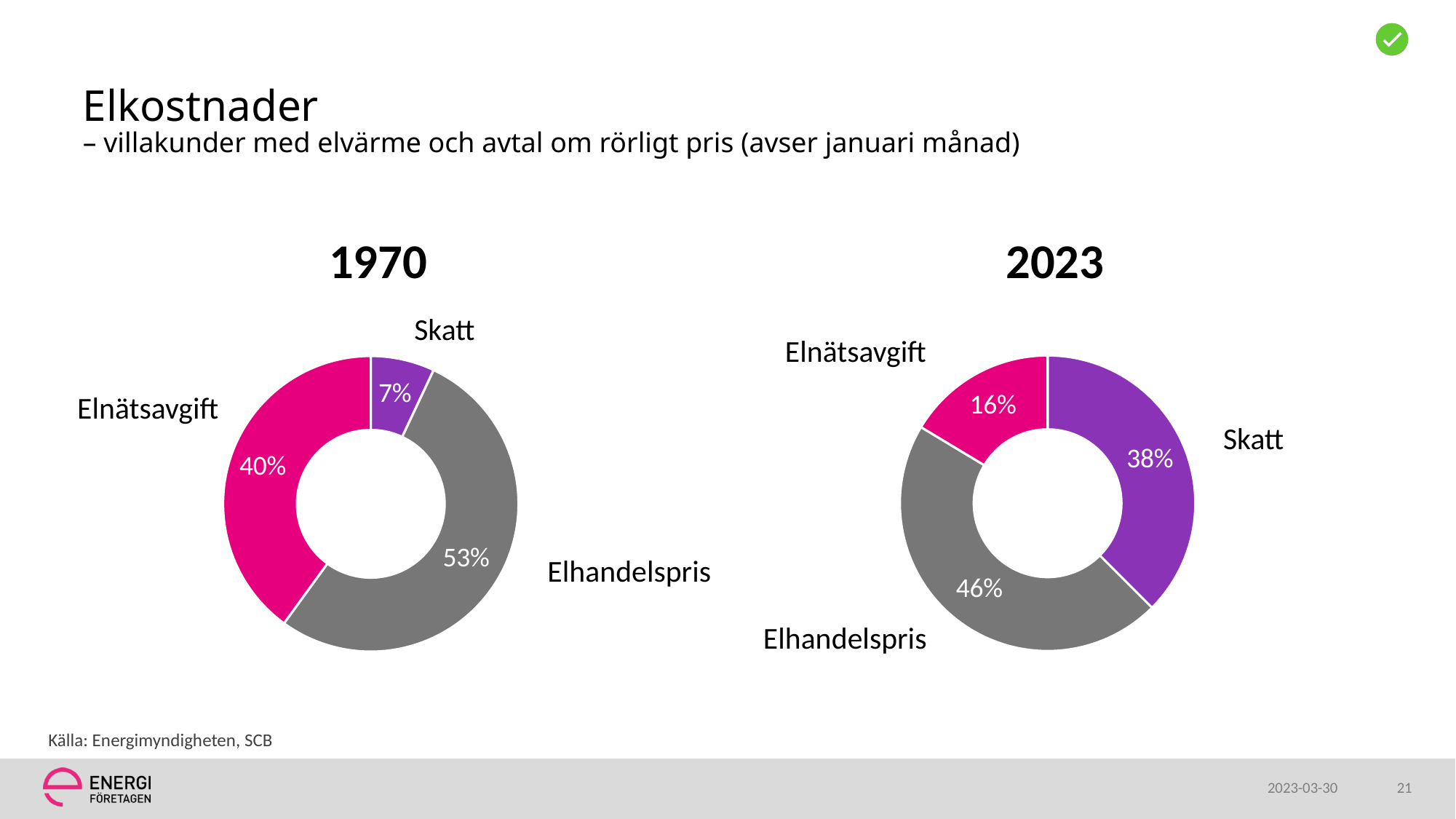
In the 1970 chart, what share does Elnätsavgift have? 40% In the 1970 chart, what share does Skatt have? 7% In the 2023 chart, which category has the smallest share? Elnätsavgift What colour is the Elhandelspris slice in the 2023 chart? Grey In the 1970 chart, what is the difference between the Elhandelspris share and the Elnätsavgift share? 13% What is the difference between the Skatt share in 2023 and the Skatt share in 1970? 31% In the 1970 chart, which category has the largest share? Elhandelspris How many categories does the 2023 chart show? 3 In the 2023 chart, what share does Skatt have? 38% In the 2023 chart, what share does Elhandelspris have? 46% What kind of chart is the 1970 chart? Doughnut chart In the 2023 chart, which is larger, Skatt or Elnätsavgift? Skatt